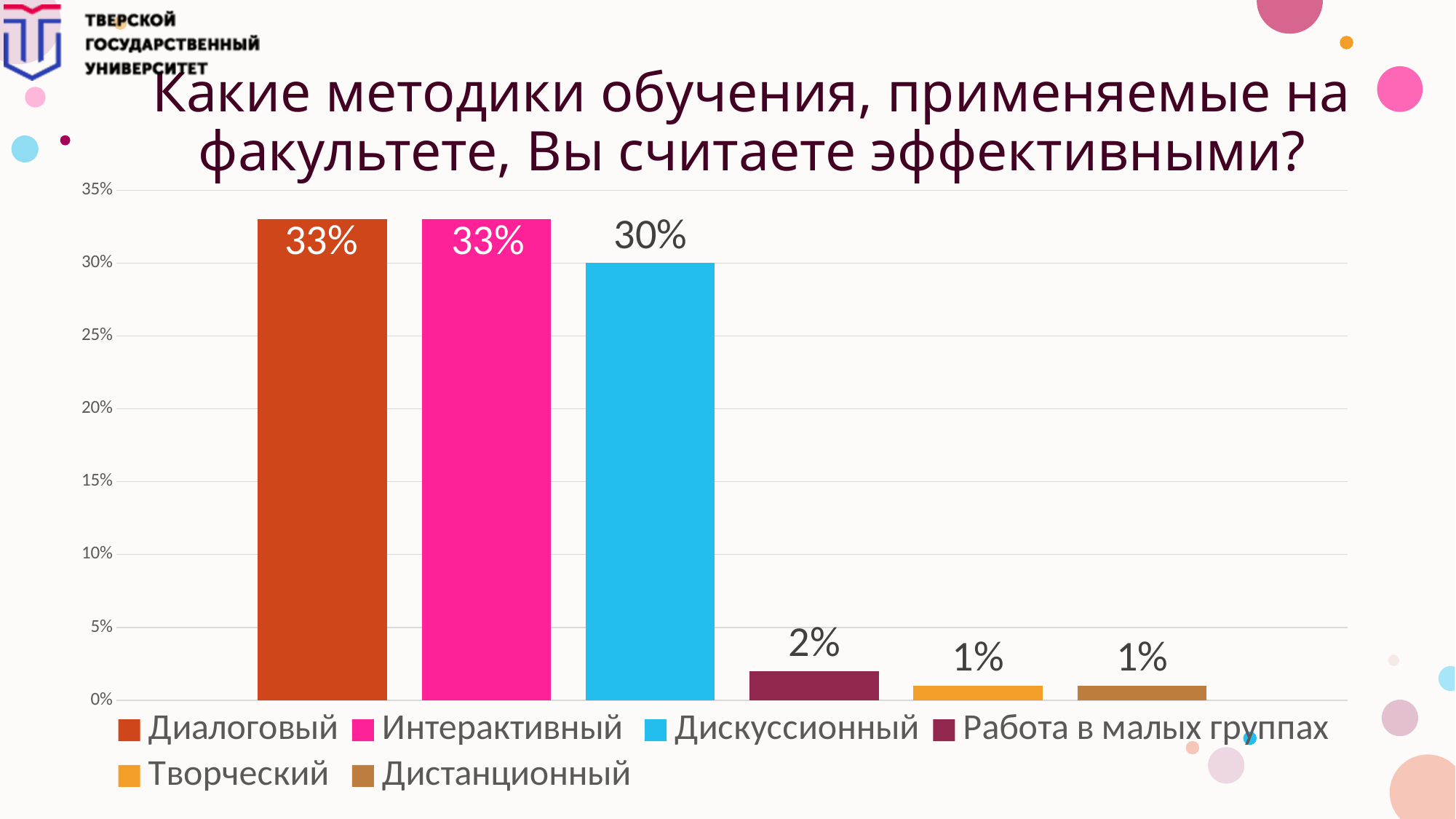
What value is shown for Диалоговый? 33% What value is shown for Работа в малых группах? 2% What value is shown for Дискуссионный? 30% What is the difference between the values for Диалоговый and Дискуссионный? 3% What is the difference between the values for Дискуссионный and Работа в малых группах? 28% How many bars are plotted on the chart? 6 How many entries does the legend list? 6 What value is shown for Творческий? 1% Which is larger, the value for Дискуссионный or the value for Работа в малых группах? Дискуссионный What kind of chart is shown on the slide? bar chart What value is shown for Интерактивный? 33% Is the value for Дискуссионный greater or less than 25%? greater